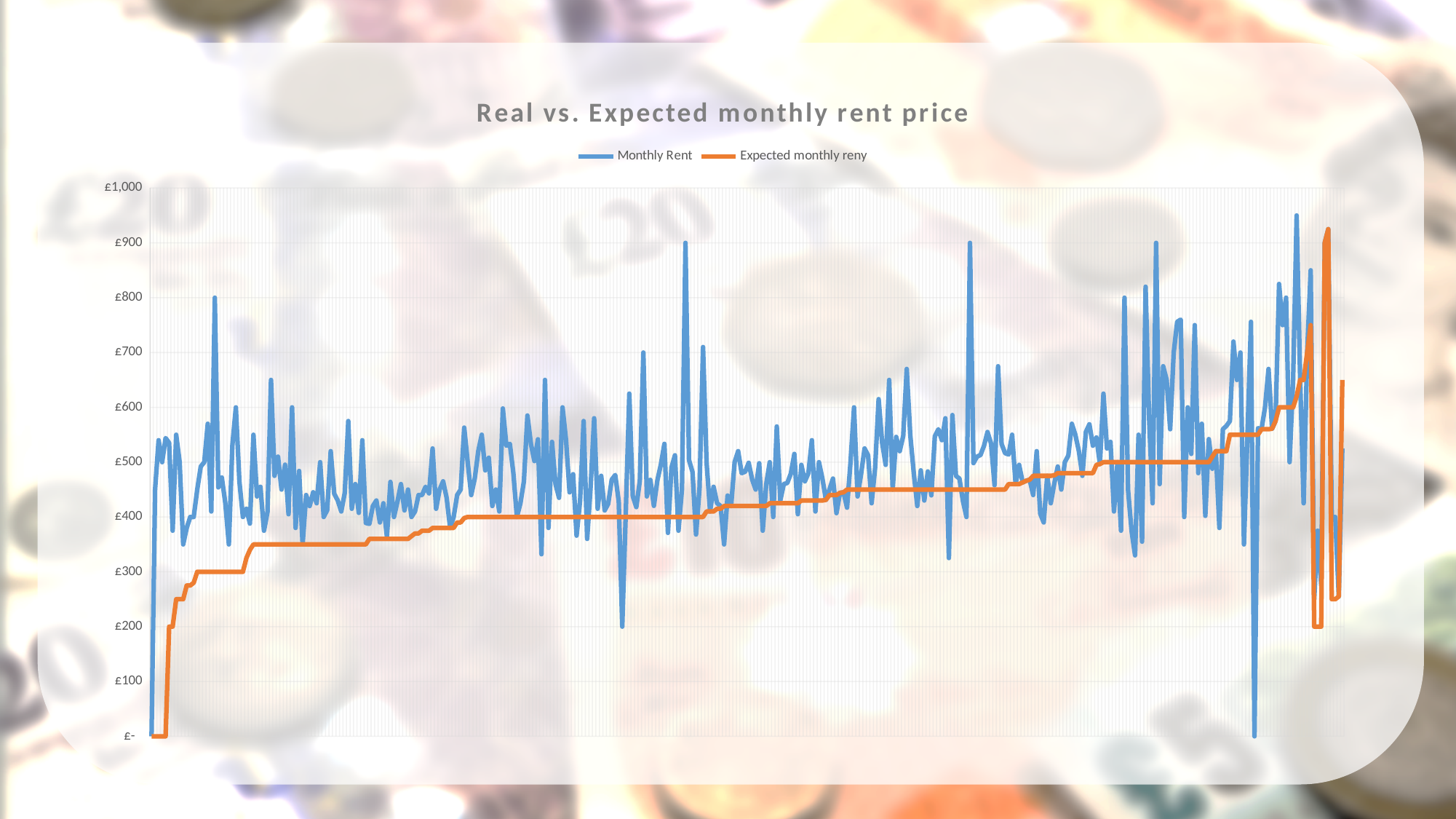
Which colour is used for the Monthly Rent series? blue What is the lowest tick label shown on the y axis? £- What kind of chart is shown on the slide? line chart How many series does the legend list? 2 Does the Expected monthly reny series generally rise or fall from left to right along the x axis? rise What is the highest value shown on the y axis? £1,000 What is the title of the chart? Real vs. Expected monthly rent price